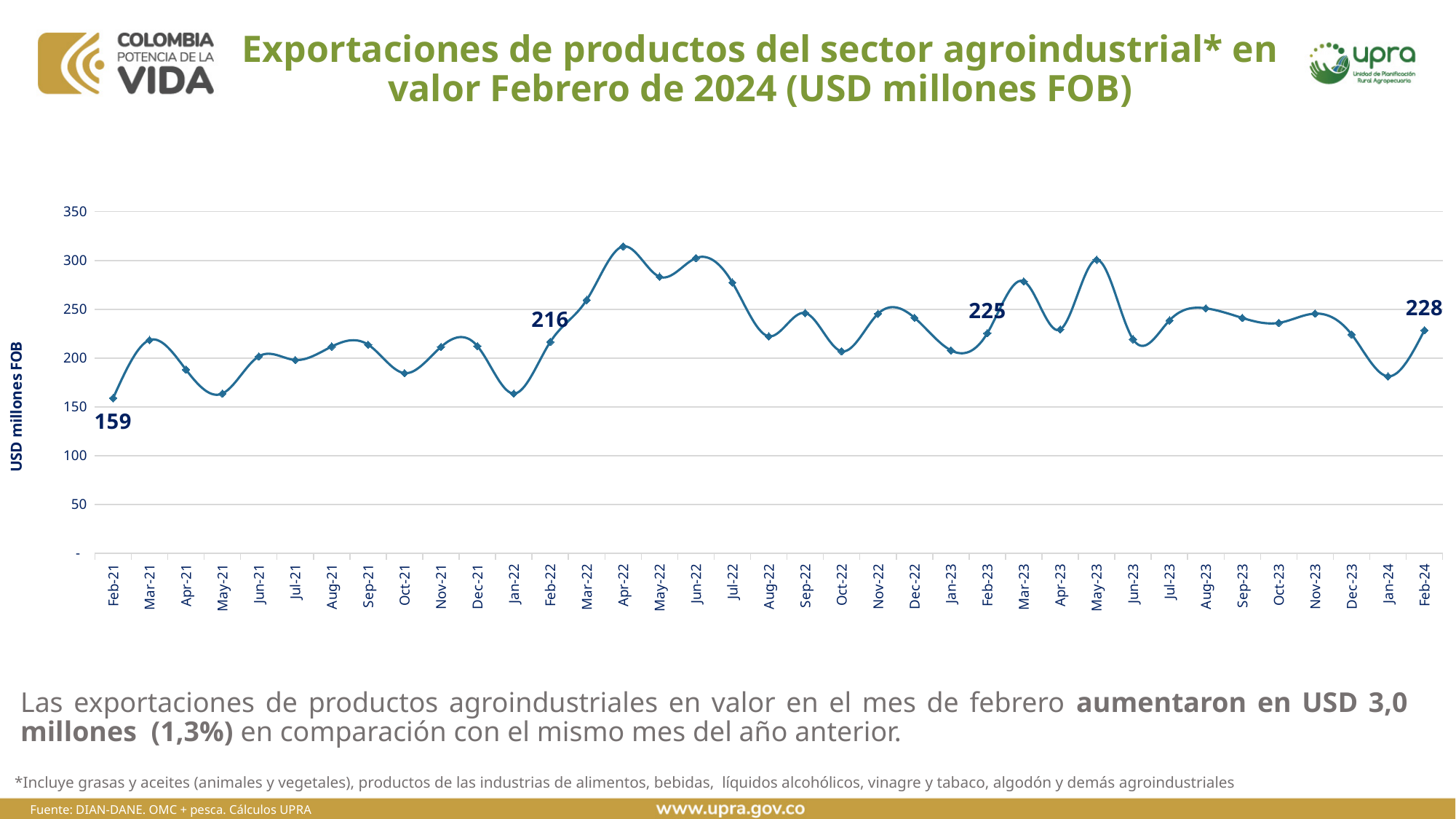
What is the value for Feb-23? 225 Is the value for Jan-24 greater or less than 200? less Which month has the highest value on the chart? Apr-22 Which is larger, the value for Feb-21 or the value for Feb-24? Feb-24 What is the difference between the values for Feb-22 and Feb-21? 57 What is the value for Feb-21? 159 How many monthly data points are plotted on the chart? 37 What is the value for Feb-24? 228 What is the difference between the values for Feb-24 and Feb-23? 3 Is the value for Apr-22 greater or less than 300? greater What is the value for Feb-22? 216 What type of chart is shown on the slide? line chart